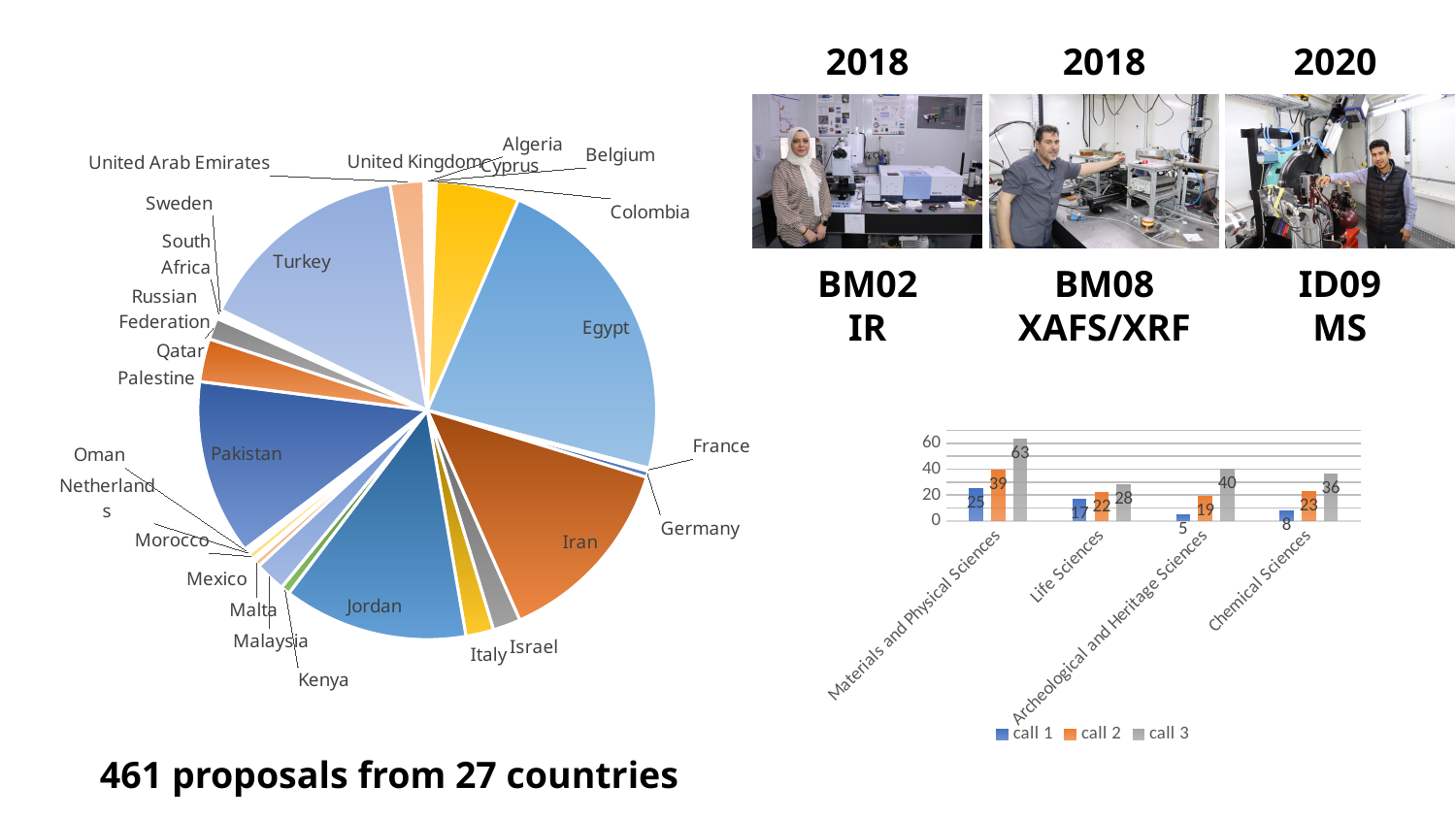
In the bar chart, what is the call 3 value for Materials and Physical Sciences? 63 How many countries are shown as slices in the pie chart? 27 In the bar chart, what is the difference between the call 3 and call 1 values for Life Sciences? 11 In the pie chart, which country has the largest slice? Egypt What kind of chart is the chart on the left of the slide? pie chart How many categories are shown on the x axis of the bar chart? 4 How many series does the legend of the bar chart list? 3 In the bar chart, which is larger: the call 2 value for Life Sciences or the call 2 value for Chemical Sciences? Chemical Sciences In the bar chart, which category has the lowest call 1 value? Archeological and Heritage Sciences In the bar chart, what is the call 1 value for Archeological and Heritage Sciences? 5 In the bar chart, which category has the highest call 3 value? Materials and Physical Sciences In the bar chart, what is the call 2 value for Chemical Sciences? 23